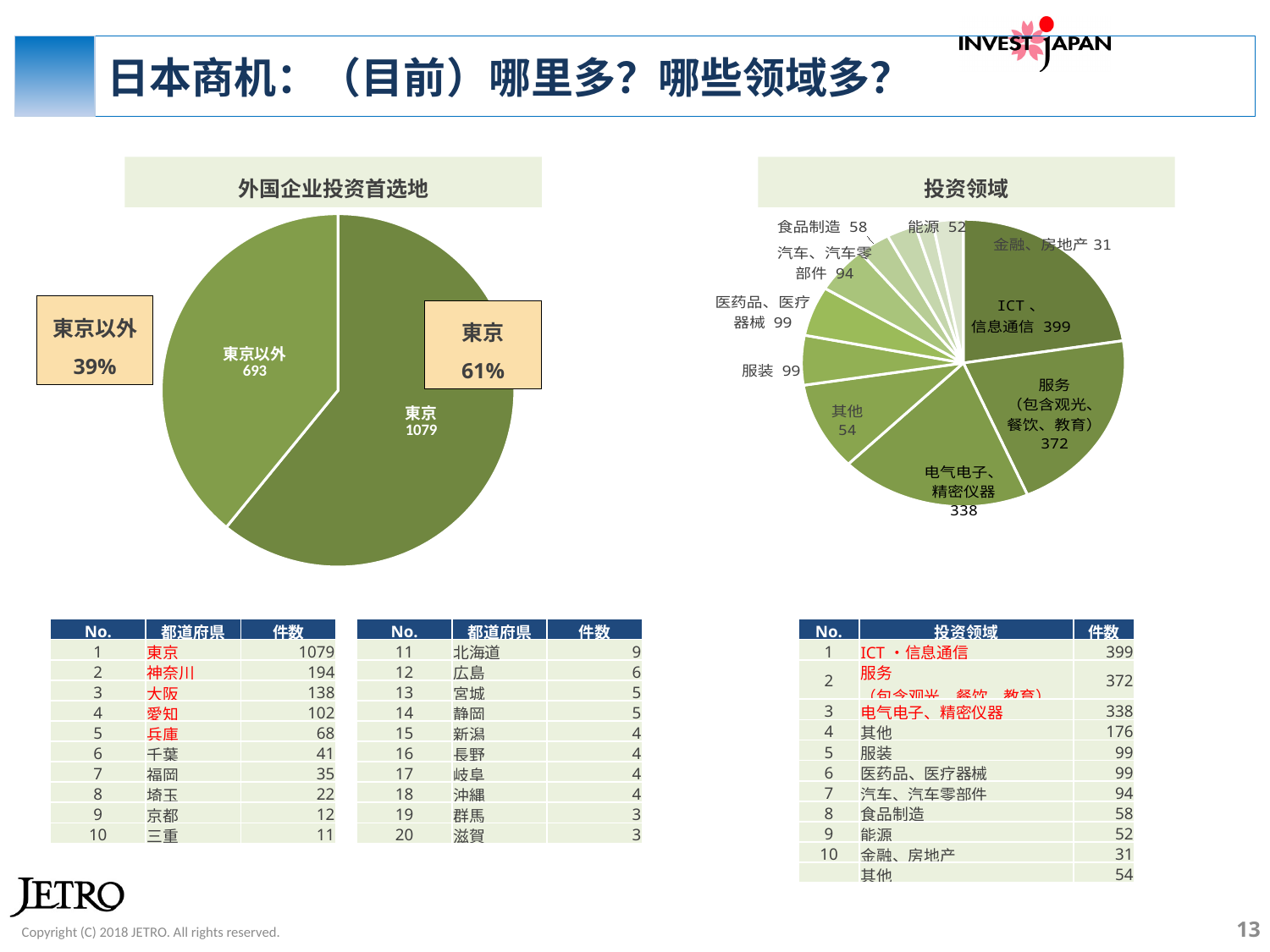
In the '投资领域' chart, what is the difference between 服务 and 电气电子、精密仪器? 34 In the '投资领域' chart, which category has the largest value? ICT、信息通信 In the '投资领域' chart, which is larger: 食品制造 or 能源? 食品制造 In the '外国企业投资首选地' chart, what is the value for 東京? 1079 In the '外国企业投资首选地' chart, what percentage share does 東京 have? 61% In the '投资领域' chart, what is the value for ICT、信息通信? 399 In the '外国企业投资首选地' chart, what is the difference between 東京 and 東京以外? 386 What type of chart is the '外国企业投资首选地' chart on the left? pie chart In the '投资领域' chart, what is the value for 电气电子、精密仪器? 338 In the '投资领域' chart, which category has the smallest value? 金融、房地产 In the '外国企业投资首选地' chart, what is the value for 東京以外? 693 How many slices does the '投资领域' pie chart have? 11